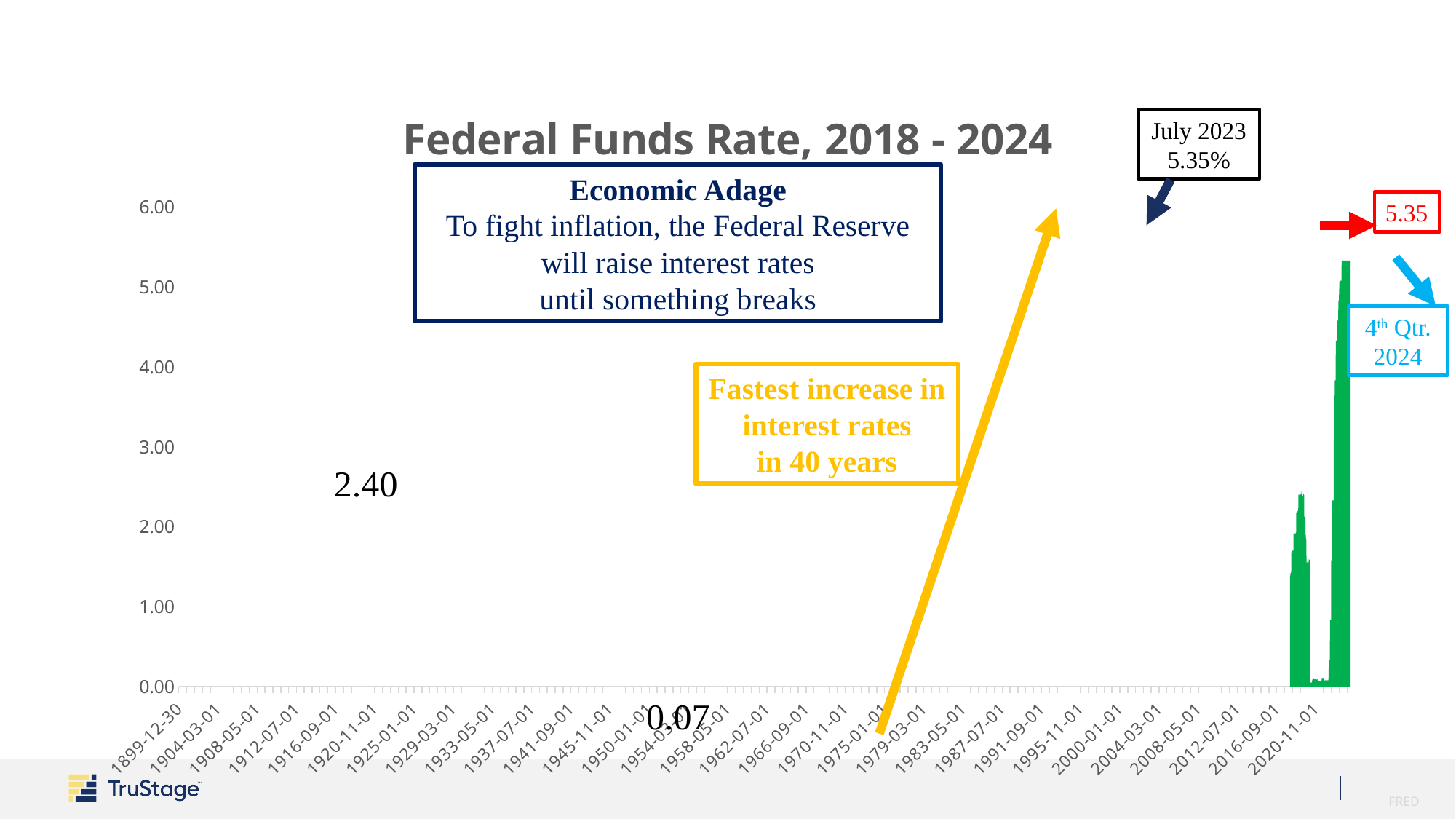
Does the Federal Funds Rate rise or fall between the labeled value 0.07 and the labeled value 5.35? rise What is the difference between the labeled values 5.35 and 0.07? 5.28 What is the difference between the labeled values 5.35 and 2.40? 2.95 Which labeled value is larger, 2.40 or 5.35? 5.35 What period does the blue annotation box at the right of the chart refer to? 4th Qtr. 2024 What is the highest tick value shown on the vertical axis? 6.00 What is the title of the chart? Federal Funds Rate, 2018 - 2024 What is the lowest value labeled on the chart? 0.07 Is the peak value of the Federal Funds Rate shown on the chart greater or less than 5.00? greater What is the highest value labeled on the chart? 5.35 According to the annotation, what was the Federal Funds Rate in July 2023? 5.35%